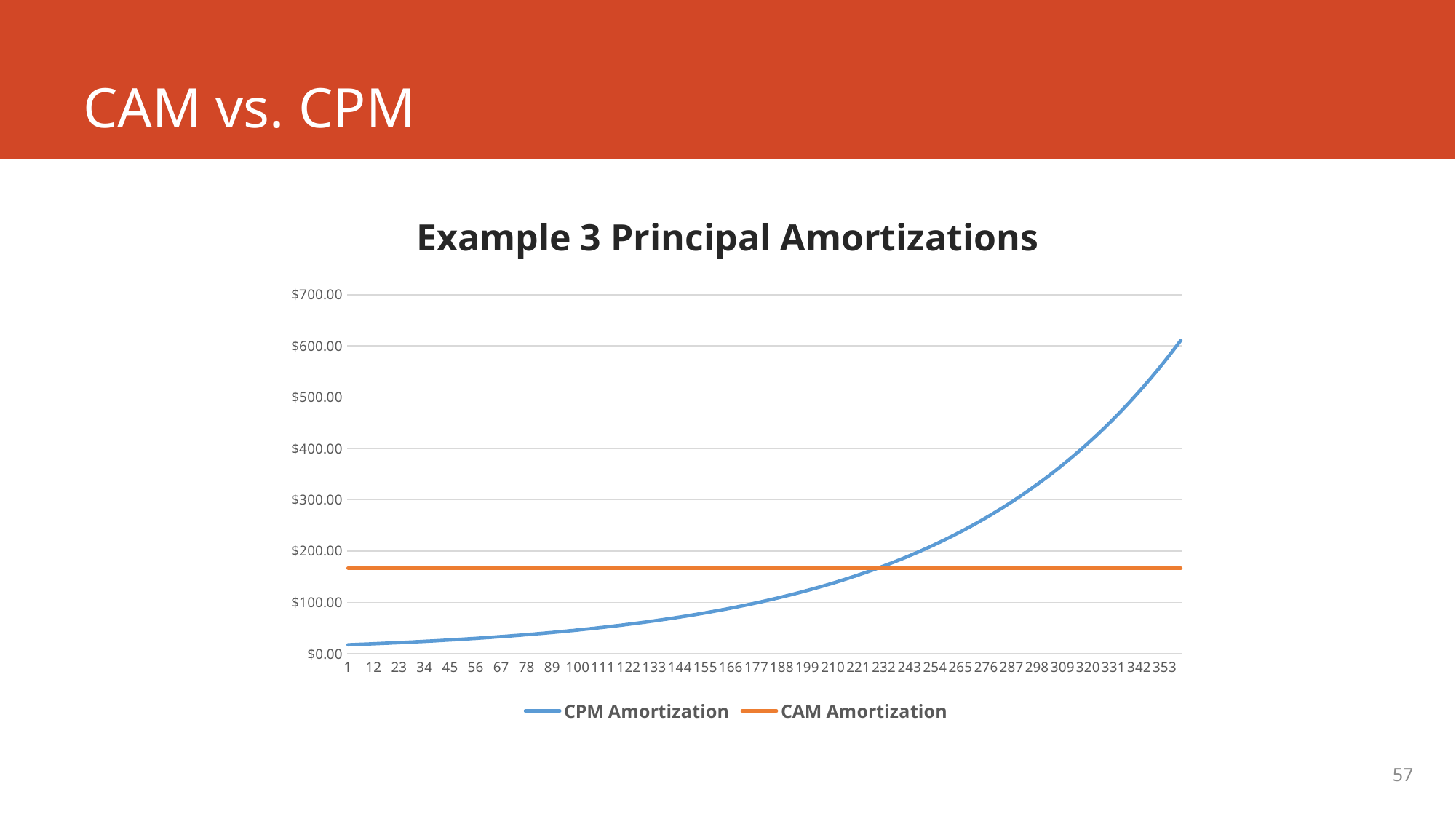
What kind of chart is shown on the slide? line chart Is the value of CAM Amortization greater or less than $100.00? greater How many series does the legend list? 2 Is the value of CPM Amortization at period 1 greater or less than $100.00? less Is the value of CAM Amortization greater or less than $200.00? less Does the CAM Amortization line rise, fall, or stay flat along the x axis? stay flat At period 353, which series has the larger value, CPM Amortization or CAM Amortization? CPM Amortization At period 1, which series has the larger value, CPM Amortization or CAM Amortization? CAM Amortization What is the title of the chart? Example 3 Principal Amortizations Which series is drawn in orange? CAM Amortization Does the CPM Amortization line rise or fall along the x axis? rise